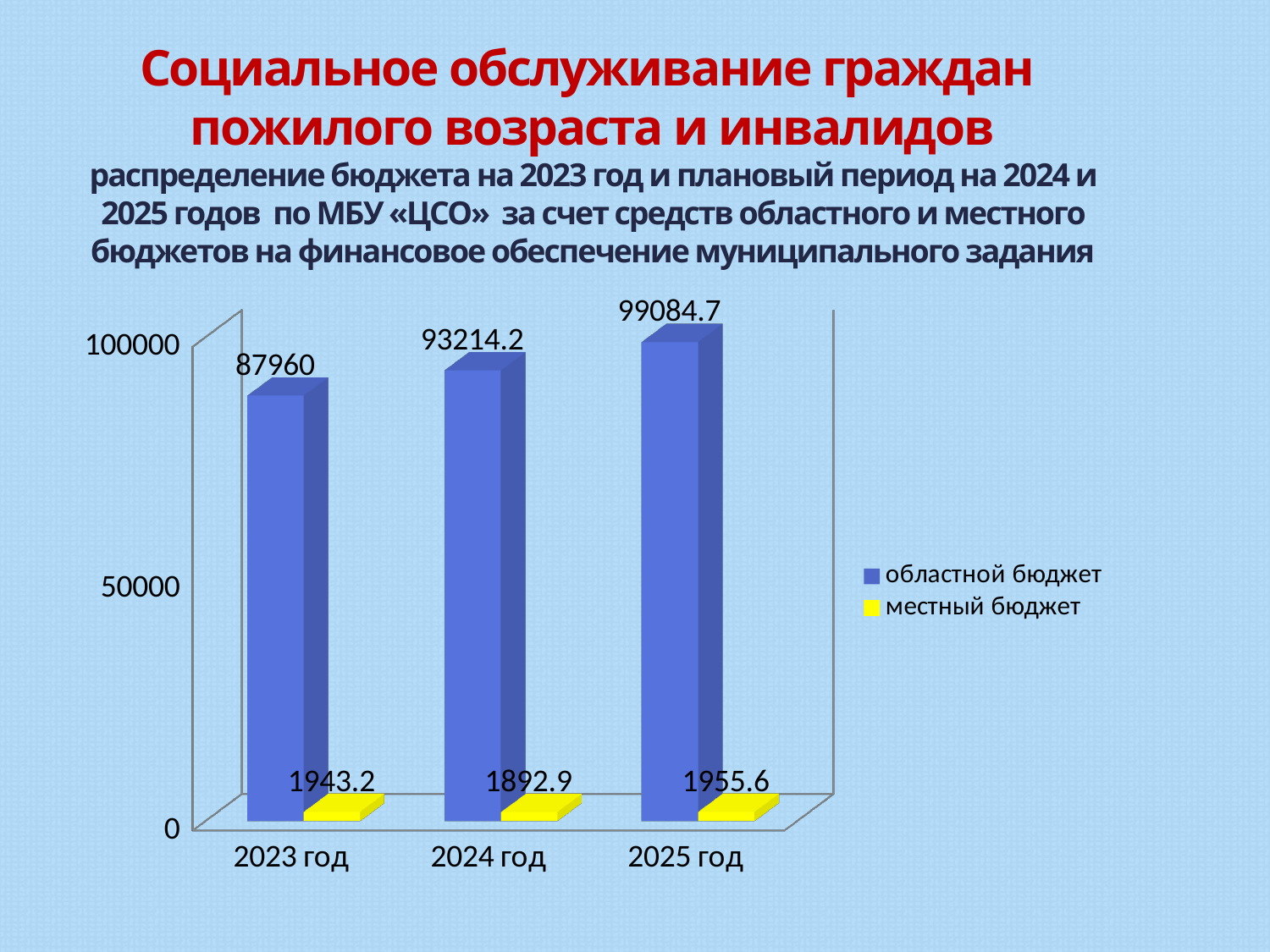
What is the difference between областной бюджет in 2025 год and in 2023 год? 11124.7 Which is larger: областной бюджет in 2024 год or областной бюджет in 2023 год? 2024 год What is the value for местный бюджет in 2024 год? 1892.9 How many series does the legend list? 2 What is the value for областной бюджет in 2023 год? 87960 What is the value for областной бюджет in 2025 год? 99084.7 In which year is местный бюджет lowest? 2024 год In which year is областной бюджет highest? 2025 год What is the difference between местный бюджет in 2025 год and in 2024 год? 62.7 Does областной бюджет rise or fall from 2023 год to 2025 год? rise How many years are shown on the x axis? 3 What is the value for местный бюджет in 2025 год? 1955.6